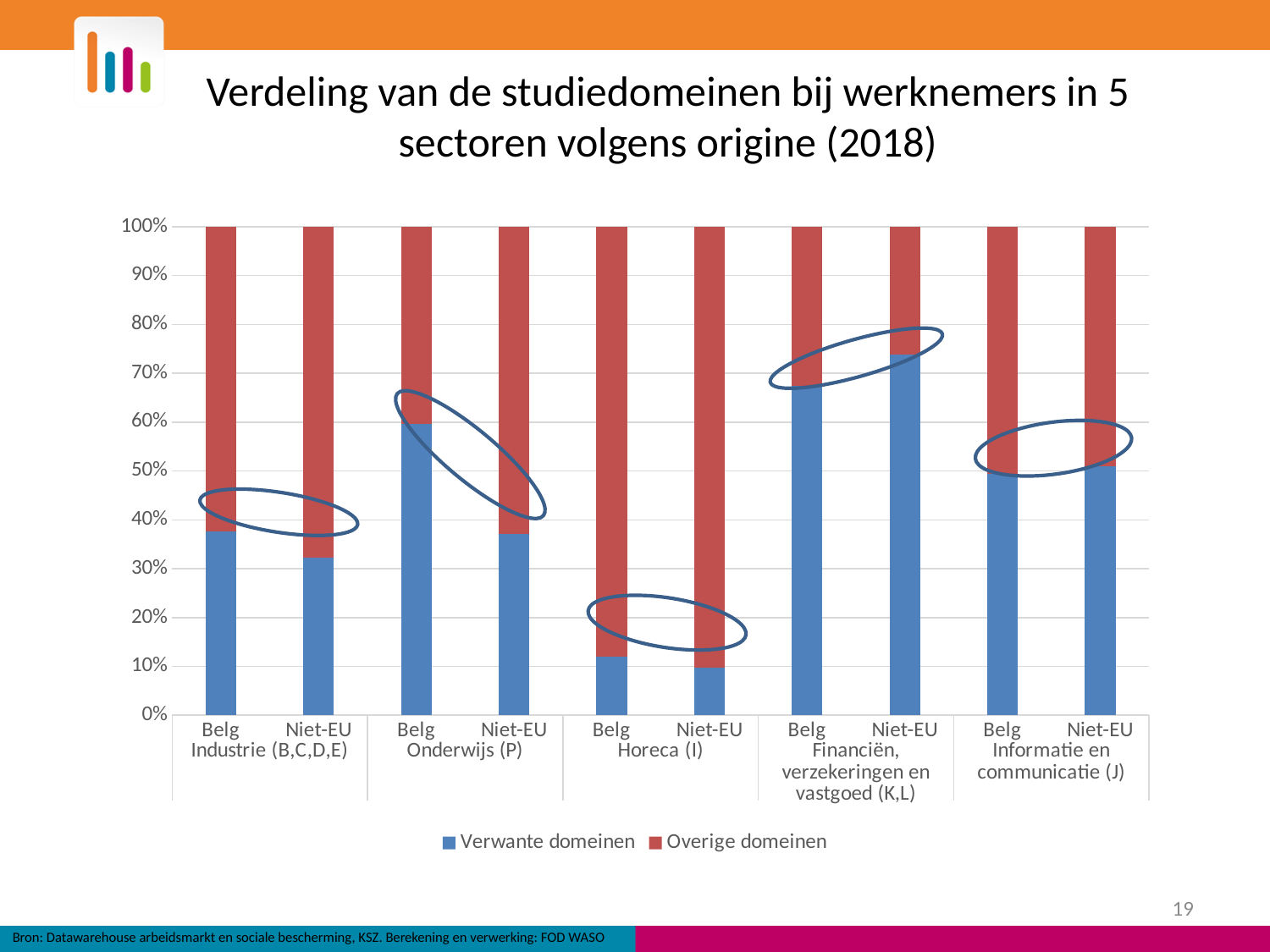
How many bars are plotted in the chart? 10 Is the share of Verwante domeinen for Belg workers in Onderwijs (P) greater or less than 50%? greater What kind of chart is shown on the slide? Stacked bar chart Which colour represents Overige domeinen in the chart? Red How many sectors are shown along the x axis? 5 Which bar has the largest share of Verwante domeinen? Niet-EU, Financiën, verzekeringen en vastgoed (K,L) Which sector has the smallest share of Verwante domeinen for Belg workers? Horeca (I) In Onderwijs (P), which group has the larger share of Verwante domeinen, Belg or Niet-EU? Belg Is the share of Verwante domeinen for Niet-EU workers in Industrie (B,C,D,E) greater or less than 40%? less In Financiën, verzekeringen en vastgoed (K,L), which group has the larger share of Verwante domeinen, Belg or Niet-EU? Niet-EU Is the share of Verwante domeinen for Belg workers in Horeca (I) greater or less than 20%? less How many series does the legend list? 2